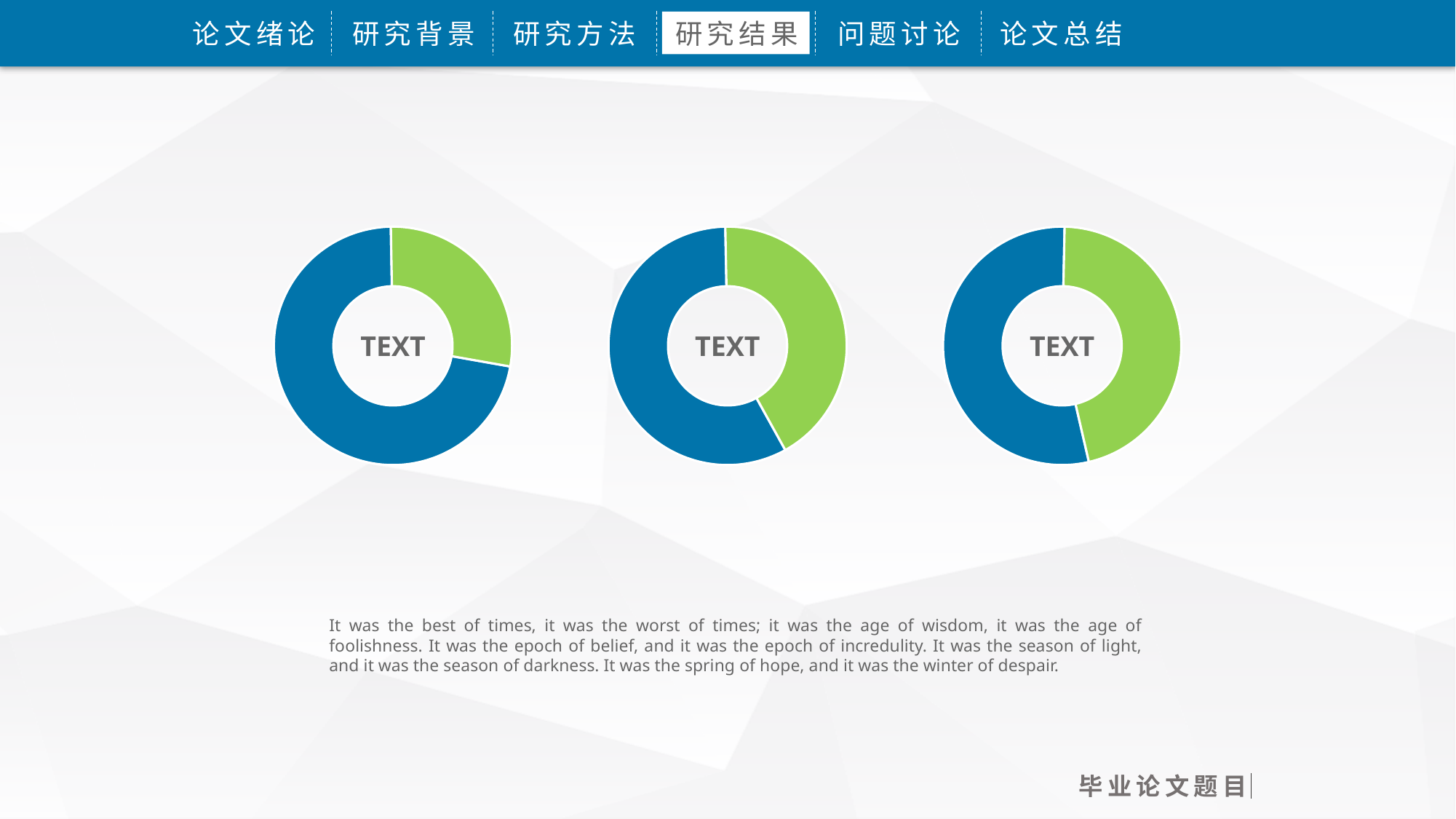
What text is shown in the centre of each donut chart? TEXT How many slices does the middle donut chart have? 2 What kind of chart is the left chart on the slide? Donut chart How many donut charts are shown on the slide? 3 How many slices does the left donut chart have? 2 What two colours are used for the slices in the donut charts? Blue and green In the right donut chart, which slice is larger, the blue one or the green one? Blue In the left donut chart, which slice is larger, the blue one or the green one? Blue In the middle donut chart, which slice is larger, the blue one or the green one? Blue